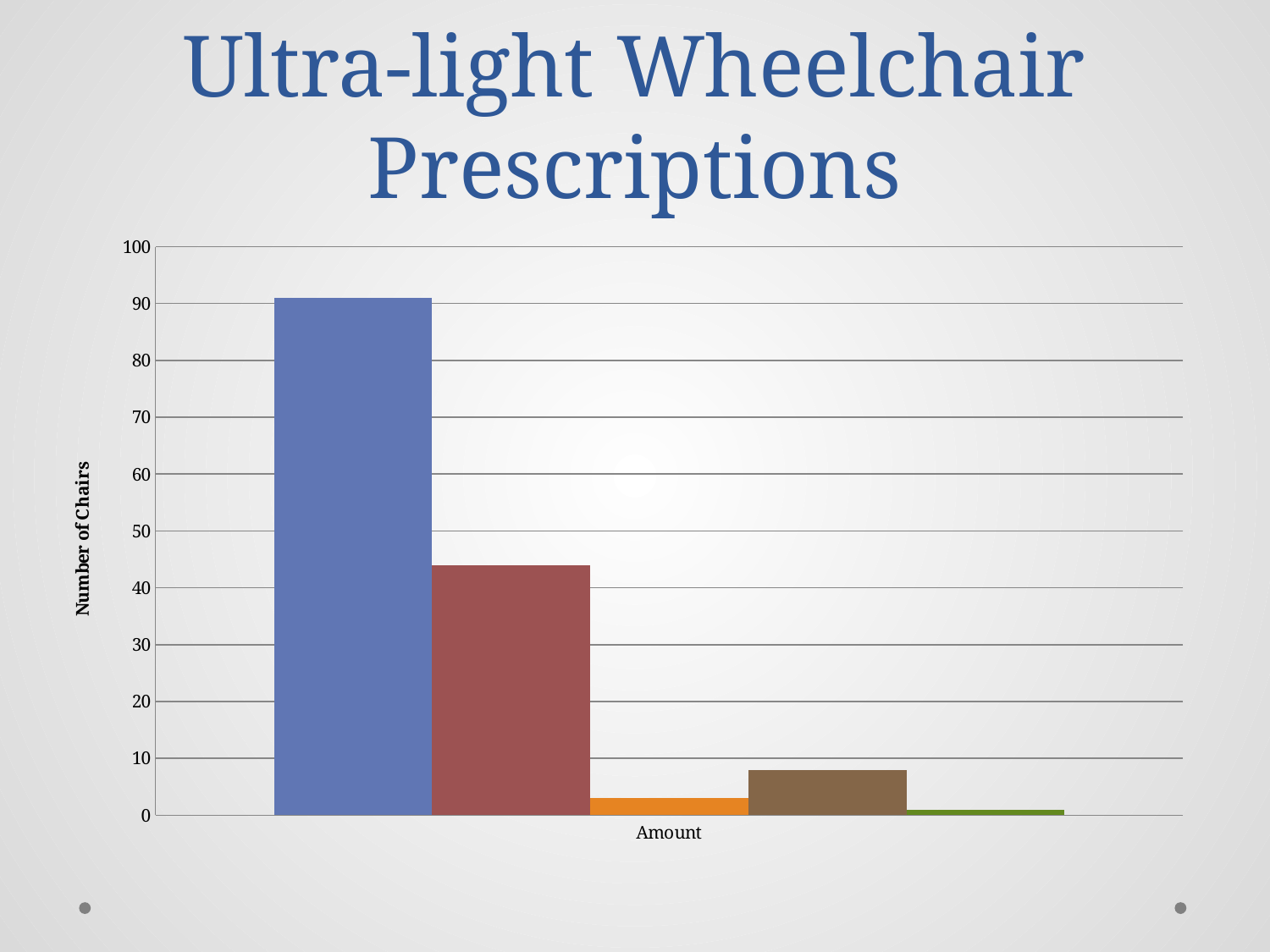
Which is larger, the orange bar or the brown bar? the brown bar Is the value for the red bar greater or less than 40? greater Which bar is the shortest in the chart? the green bar (last on the right) Is the value for the red bar greater or less than 50? less What is the title of the chart on the slide? Ultra-light Wheelchair Prescriptions How many bars are plotted in the chart? 5 What kind of chart is shown on the slide? bar chart What is the label on the vertical axis of the chart? Number of Chairs Is the value for the blue bar greater or less than 80? greater Which bar is the tallest in the chart? the blue bar (first from the left) Which is larger, the blue bar or the red bar? the blue bar